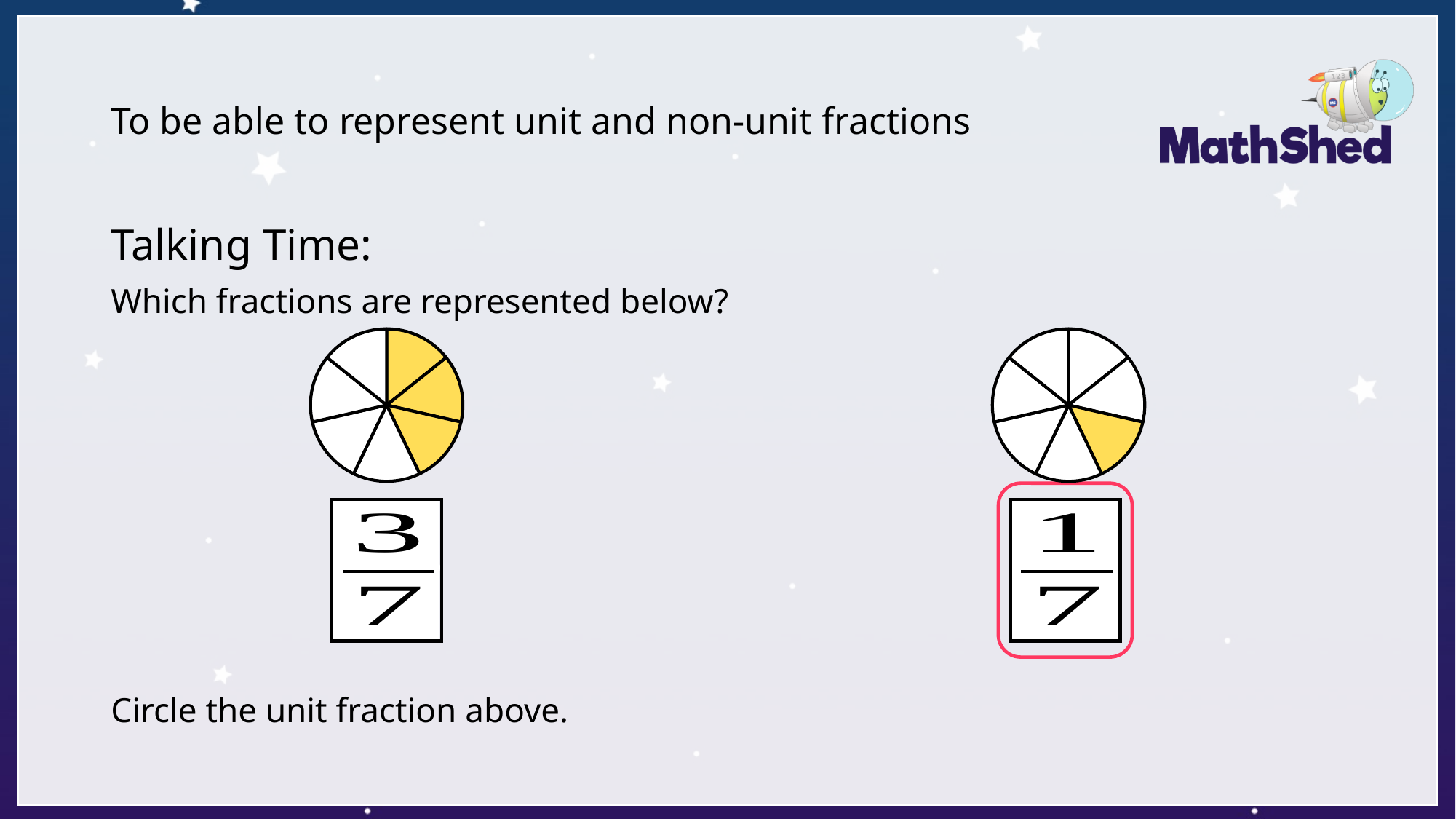
How many equal parts is the right circle divided into? 7 What share of the left circle is shaded yellow? 3/7 What colour are the shaded parts of the circles? yellow How many parts of the left circle are shaded yellow? 3 How many equal parts is the left circle divided into? 7 Which circle has the smallest shaded share? right What fraction is written below the right circle? 1/7 What share of the right circle is shaded yellow? 1/7 Which fraction on the slide is circled in pink? 1/7 What fraction is written below the left circle? 3/7 Which circle has the larger shaded share, the left or the right? left